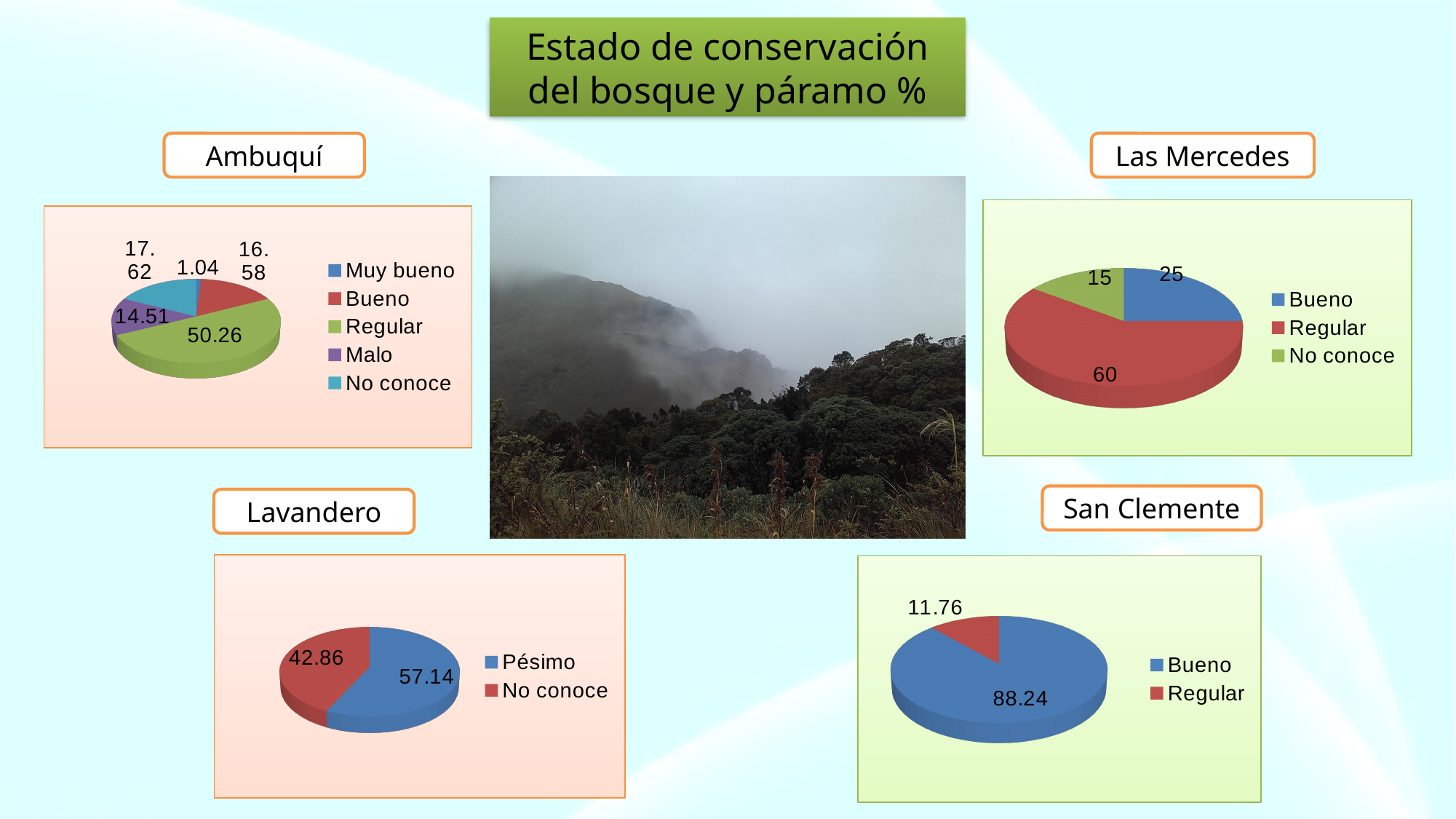
In the San Clemente chart, what is the value for Bueno? 88.24 In the San Clemente chart, what colour is the Regular slice? Red In the Lavandero chart, what is the value for Pésimo? 57.14 In the Lavandero chart, what is the difference between Pésimo and No conoce? 14.28 In the Ambuquí chart, what is the difference between No conoce and Malo? 3.11 What kind of chart is the San Clemente chart? Pie chart In the Ambuquí chart, what is the value for Regular? 50.26 In the Ambuquí chart, how many categories does the legend list? 5 In the Las Mercedes chart, what is the value for Regular? 60 In the Las Mercedes chart, which is larger, Bueno or No conoce? Bueno In the Ambuquí chart, which category has the smallest slice? Muy bueno In the Las Mercedes chart, which category has the largest slice? Regular